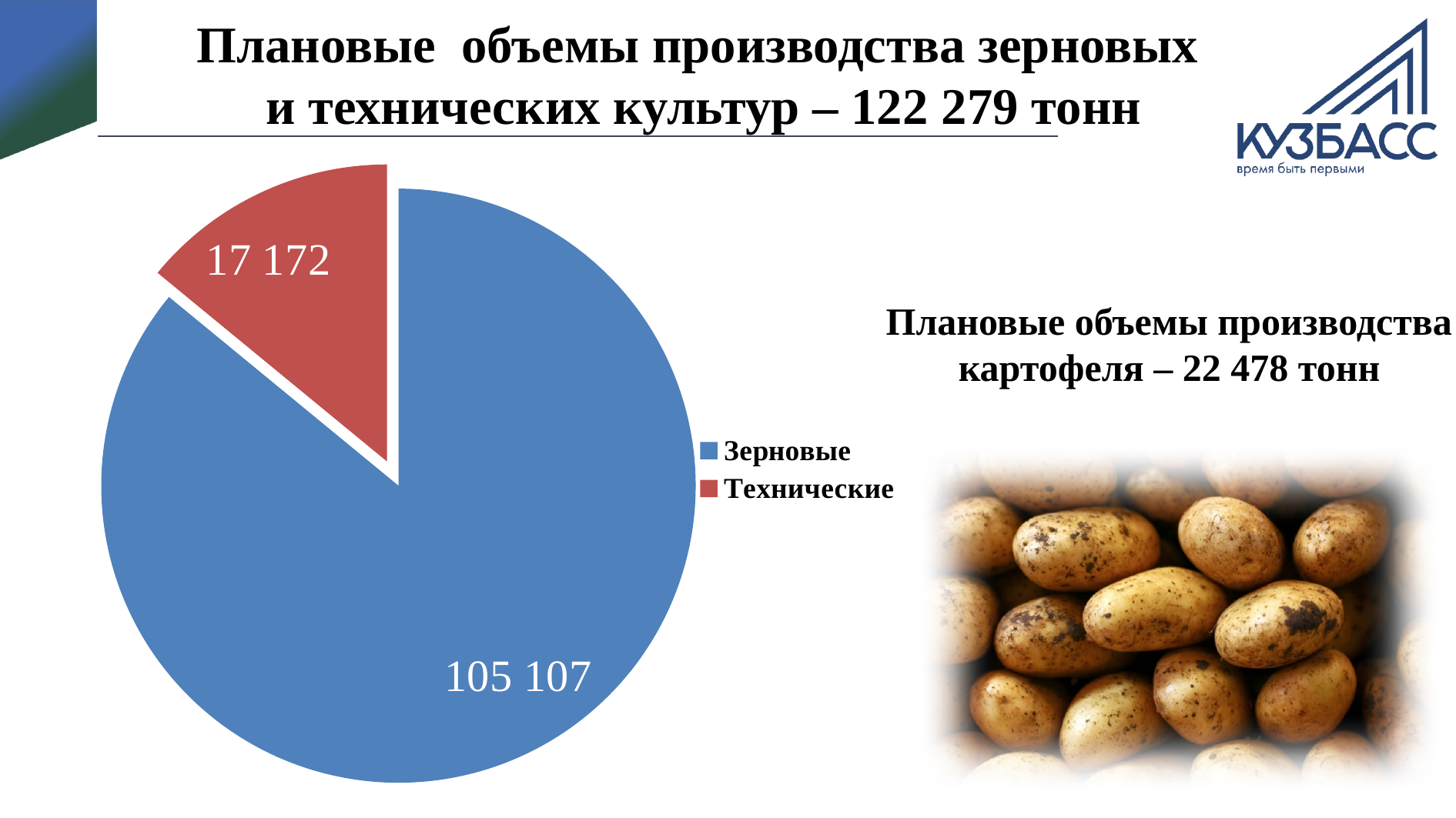
How many slices does the pie chart have? 2 What colour is the Зерновые slice in the pie chart? Blue Which is larger in the pie chart, Зерновые or Технические? Зерновые What kind of chart is shown on the slide? Pie chart Which category has the largest slice in the pie chart? Зерновые What is the planned production volume for Технические in the pie chart? 17 172 What is the planned production volume for Зерновые in the pie chart? 105 107 What is the difference between the Зерновые and Технические values in the pie chart? 87 935 Which category has the smallest slice in the pie chart? Технические What is the total of the two slices in the pie chart? 122 279 How many entries does the legend of the pie chart list? 2